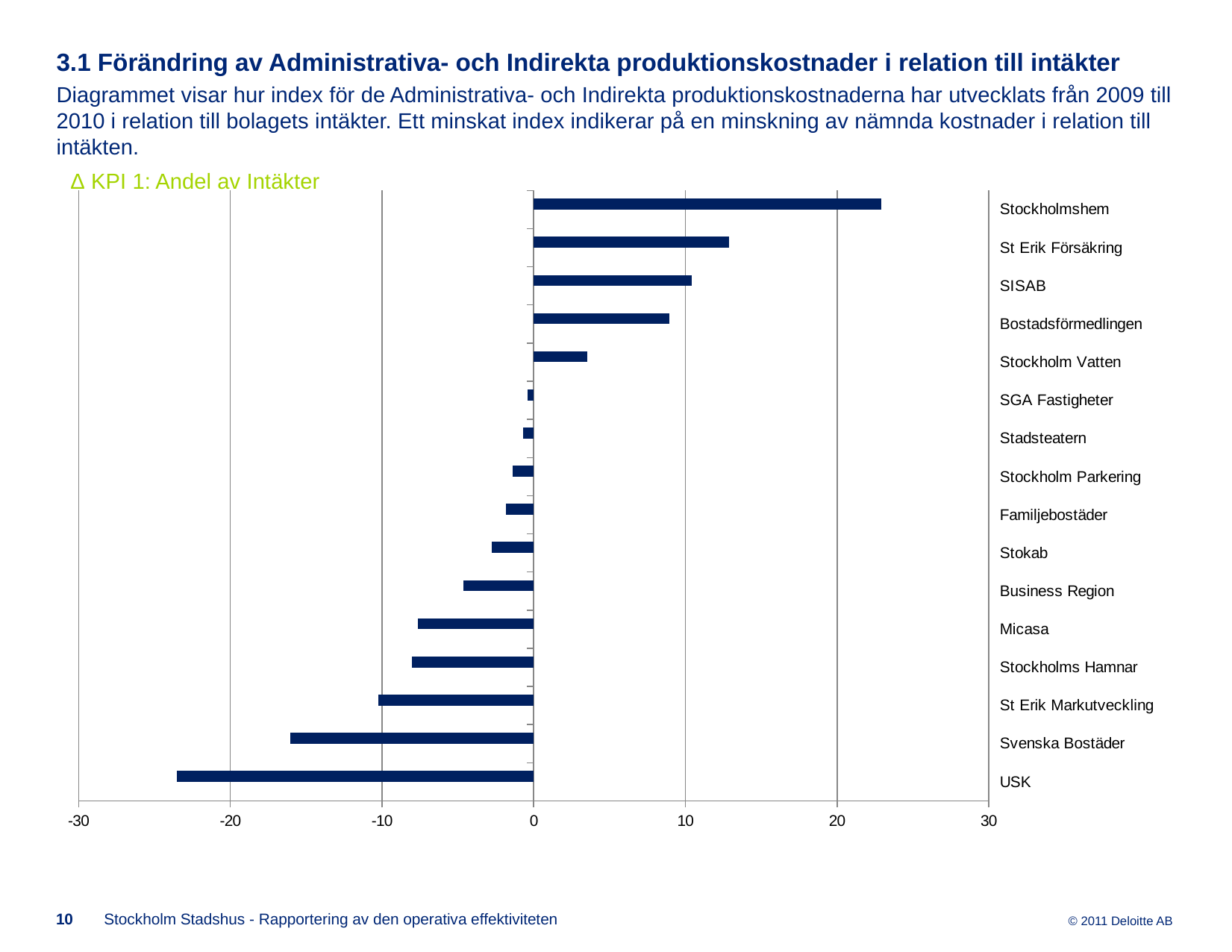
Is the value for Svenska Bostäder greater or less than -10? less Is the value for Micasa greater or less than -10? greater Is the value for St Erik Försäkring greater or less than 10? greater What kind of chart is shown on the slide? bar chart Which has the larger value, Stockholmshem or St Erik Försäkring? Stockholmshem Which company has the lowest value in the chart? USK How many companies are listed in the chart? 16 What is the title of the chart? Δ KPI 1: Andel av Intäkter Which has the lower value, Svenska Bostäder or USK? USK Which company has the highest value in the chart? Stockholmshem